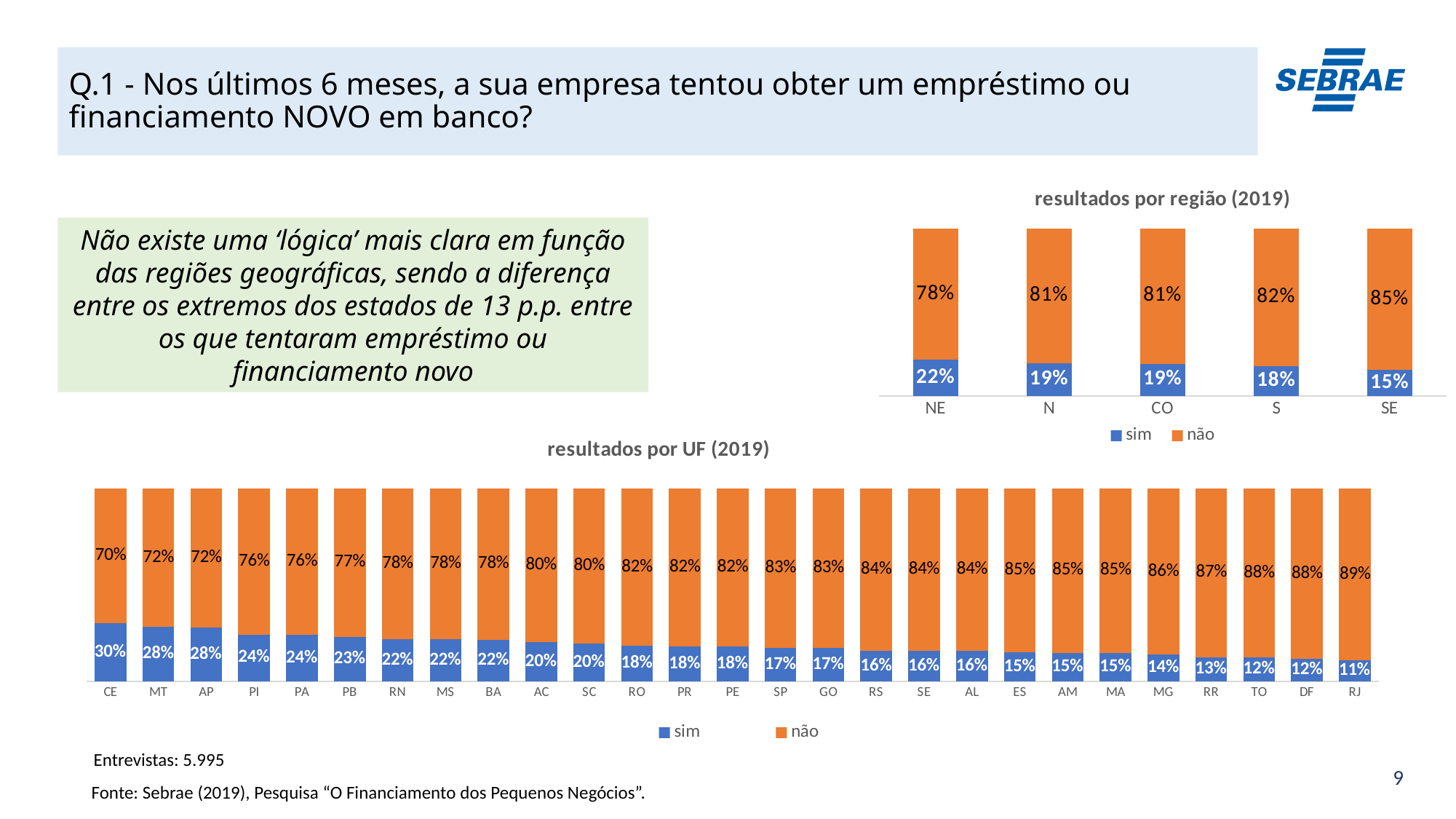
In the 'resultados por UF (2019)' chart, what is the 'sim' value for CE? 30% In the 'resultados por UF (2019)' chart, which is larger, the 'sim' value for PI or the 'sim' value for MG? PI In the 'resultados por UF (2019)' chart, how many series does the legend list? 2 In the 'resultados por região (2019)' chart, which region has the lowest 'sim' value? SE In the 'resultados por região (2019)' chart, what is the 'sim' value for NE? 22% In the 'resultados por UF (2019)' chart, how many UFs are shown? 27 In the 'resultados por região (2019)' chart, how many regions are shown? 5 In the 'resultados por região (2019)' chart, what is the difference between the 'sim' values for NE and SE? 7 p.p. In the 'resultados por UF (2019)' chart, what is the 'não' value for RJ? 89% In the 'resultados por UF (2019)' chart, which UF has the highest 'sim' value? CE What kind of chart is the 'resultados por UF (2019)' chart? Stacked bar chart In the 'resultados por região (2019)' chart, what is the 'não' value for SE? 85%